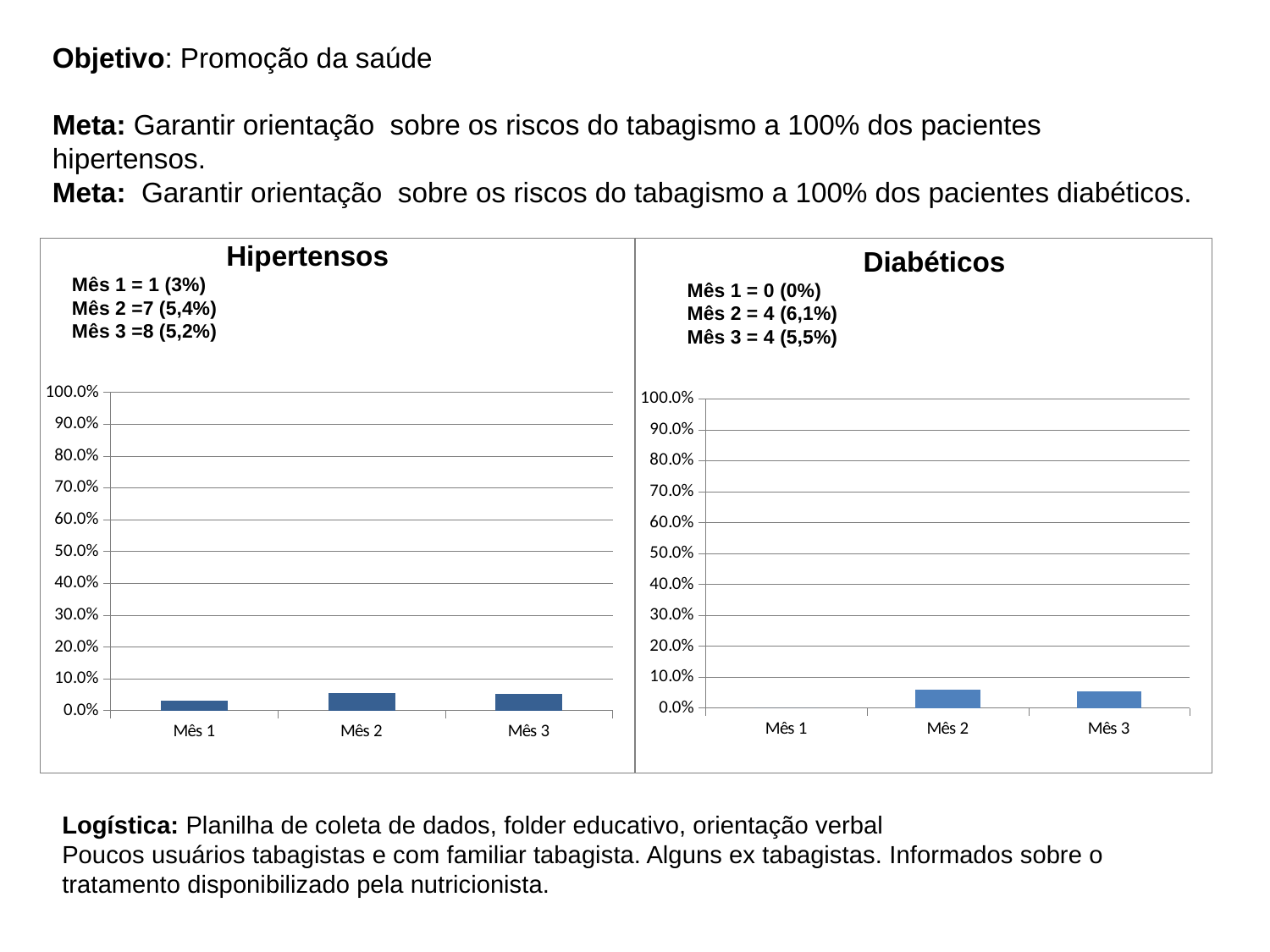
In the Hipertensos chart, is the value for Mês 2 greater or less than 10.0%? less In the Hipertensos chart, which month has the lowest value? Mês 1 In the Hipertensos chart, what percentage is shown for Mês 2? 5,4% What kind of chart is the Diabéticos chart? bar chart In the Diabéticos chart, what percentage is shown for Mês 3? 5,5% In the Diabéticos chart, which month has the highest value? Mês 2 In the Diabéticos chart, what percentage is shown for Mês 2? 6,1% How many months are plotted in the Hipertensos chart? 3 What is the title of the chart on the right side of the slide? Diabéticos In the Diabéticos chart, which month has the lowest value? Mês 1 In the Hipertensos chart, what percentage is shown for Mês 1? 3% In the Hipertensos chart, what is the difference in percentage between Mês 2 and Mês 1? 2,4%